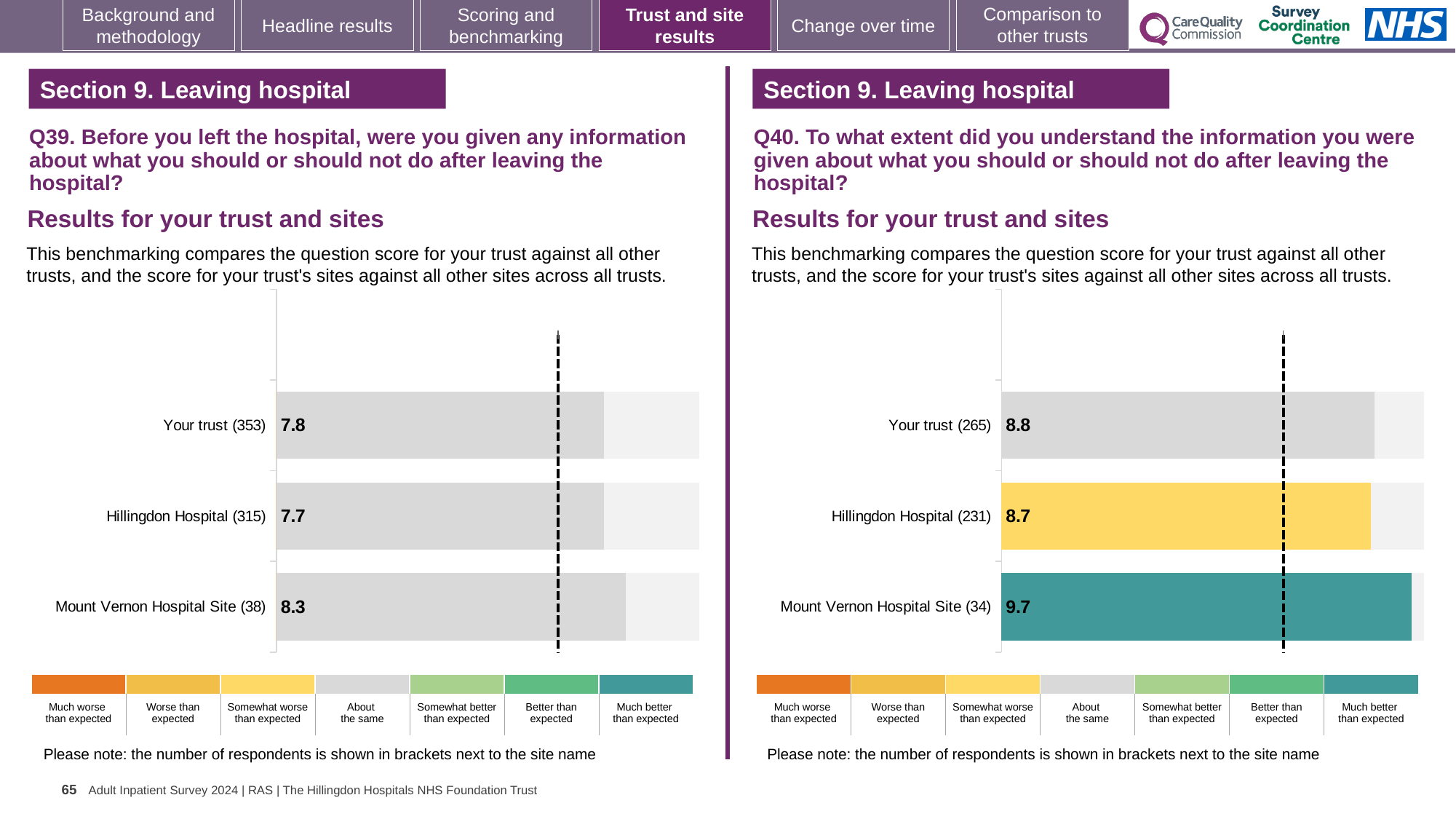
Is the score for Mount Vernon Hospital Site higher in the Q39 chart on the left or the Q40 chart on the right? Q40 chart on the right In the Q40 chart on the right, which benchmark category does the colour of the Mount Vernon Hospital Site bar correspond to? Much better than expected How many bars are shown in the Q40 chart on the right? 3 In the Q39 chart on the left, what is the difference between the scores for Mount Vernon Hospital Site and Hillingdon Hospital? 0.6 In the Q39 chart on the left, which site or trust has the lowest score? Hillingdon Hospital In the Q39 chart on the left, what is the score for Mount Vernon Hospital Site? 8.3 In the Q40 chart on the right, what is the score for Hillingdon Hospital? 8.7 In the Q40 chart on the right, how many respondents are shown in brackets for Your trust? 265 In the Q40 chart on the right, what is the difference between the scores for Mount Vernon Hospital Site and Your trust? 0.9 What type of chart is used in the Q39 chart on the left? Bar chart In the Q39 chart on the left, what is the score for Your trust? 7.8 In the Q40 chart on the right, which site or trust has the highest score? Mount Vernon Hospital Site